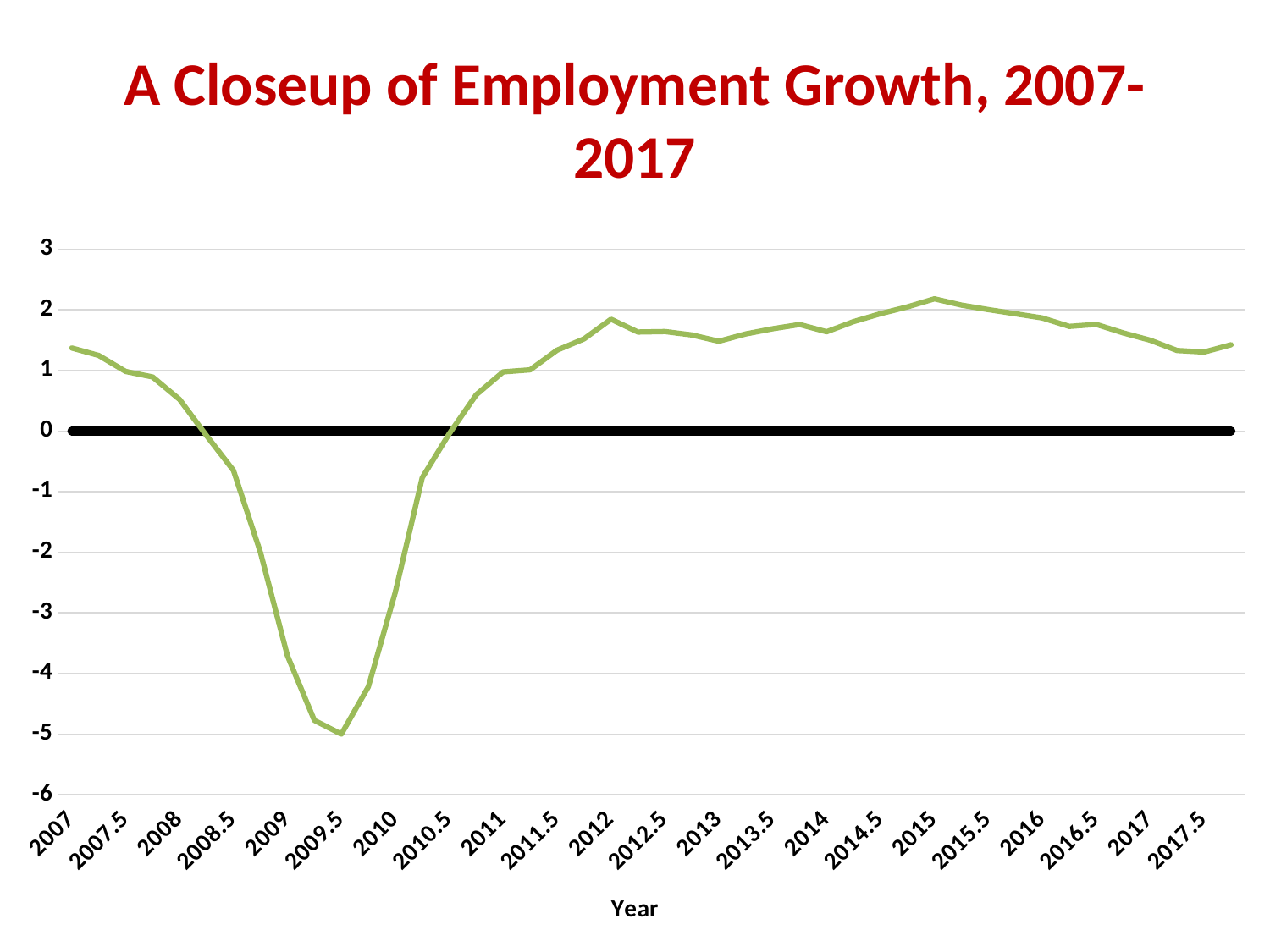
Is the value at 2009.5 greater or less than -4? less At which year on the x axis does the line reach its lowest value? 2009.5 Is the value at 2013 greater or less than 1? greater What is the label on the x axis? Year What is the title of the chart? A Closeup of Employment Growth, 2007-2017 Is the value at 2015 greater or less than 2? greater Which has the larger value, 2007 or 2015? 2015 Does the line rise or fall between 2008 and 2009.5? fall What kind of chart is shown on the slide? line chart At which year on the x axis does the line reach its highest value? 2015